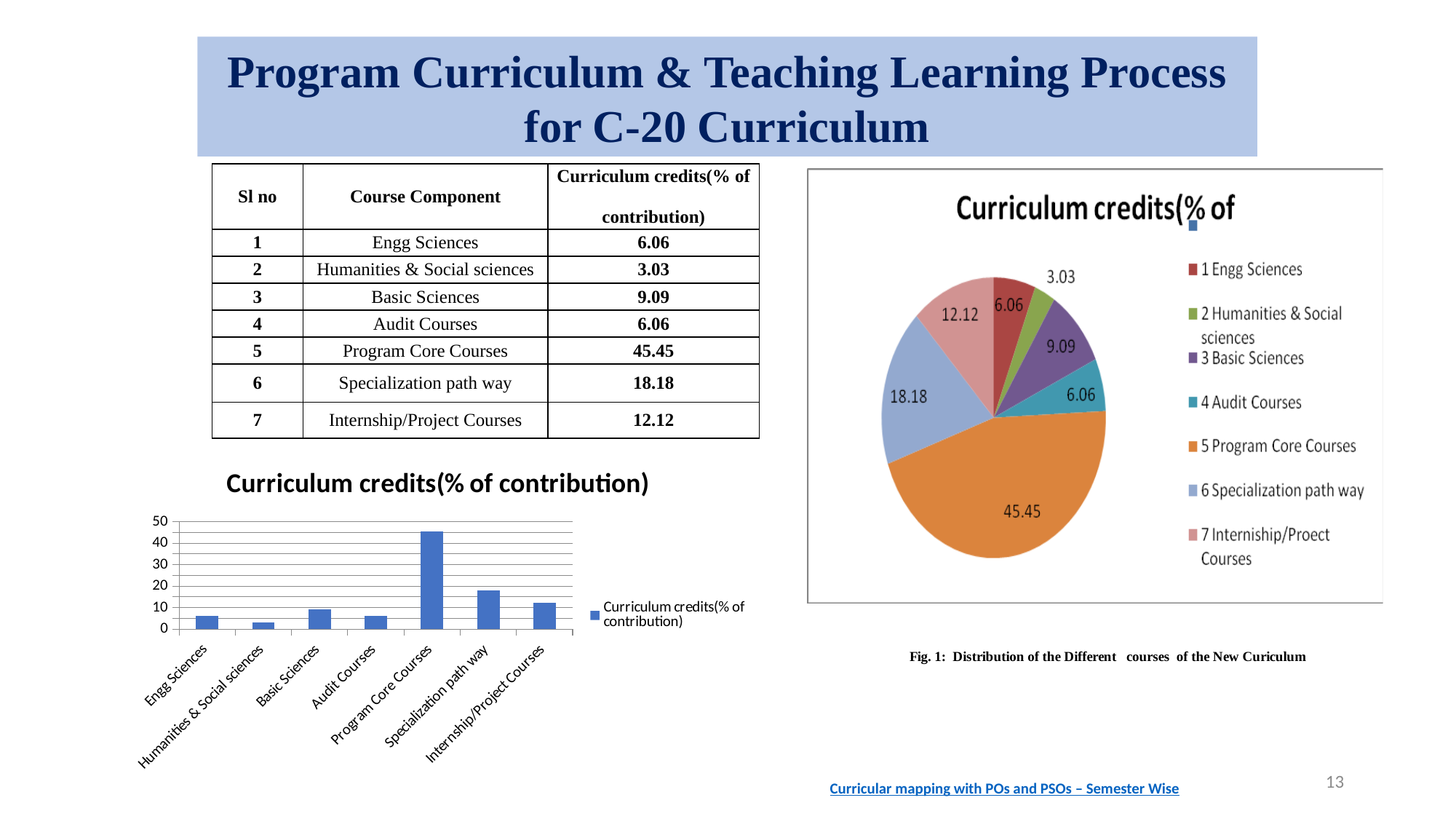
In the bar chart at the bottom left, is the value for Humanities & Social sciences greater or less than 10? less In the bar chart at the bottom left, which is larger, the value for Specialization path way or the value for Internship/Project Courses? Specialization path way What kind of chart is the chart on the right of the slide? pie chart In the pie chart on the right, what value is shown for Program Core Courses? 45.45 In the pie chart on the right, how many categories does the legend list? 7 In the pie chart on the right, which category has the smallest slice? Humanities & Social sciences In the pie chart on the right, which category has the largest slice? Program Core Courses What kind of chart is the chart at the bottom left of the slide? bar chart In the pie chart on the right, what value is shown for Specialization path way? 18.18 In the pie chart on the right, what is the difference between the values for Program Core Courses and Specialization path way? 27.27 In the pie chart on the right, what value is shown for Basic Sciences? 9.09 In the bar chart at the bottom left, is the value for Program Core Courses greater or less than 40? greater